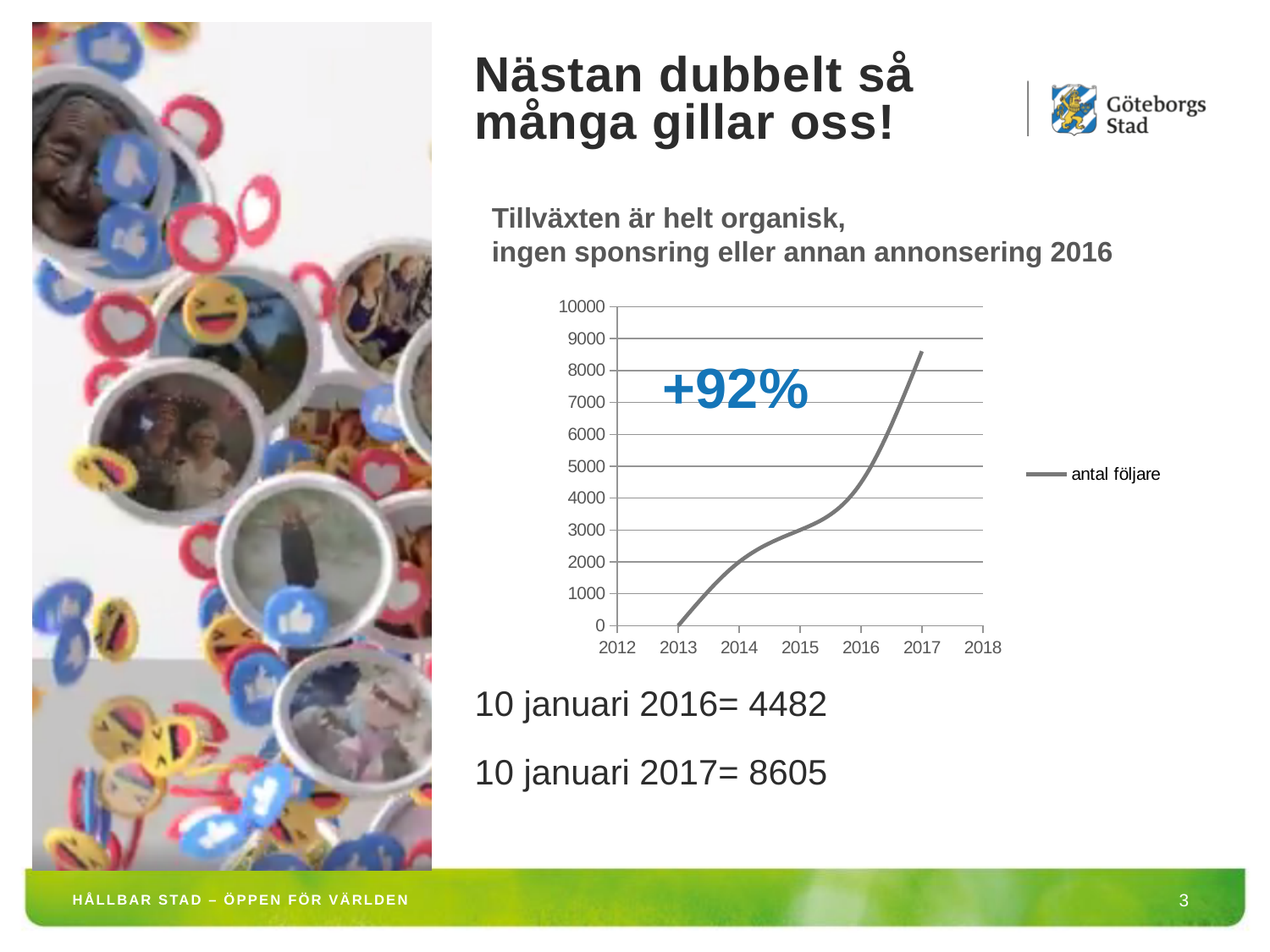
In which year does the line for antal följare reach its highest value? 2017 What kind of chart is shown on the slide? line chart Which year has the larger value for antal följare, 2015 or 2016? 2016 Is the value for antal följare in 2017 greater or less than 8000? greater Is the value for antal följare in 2015 greater or less than 4000? less Do the values of antal följare rise or fall from 2013 to 2017? rise How many series does the chart legend list? 1 In which year does the line for antal följare have its lowest value? 2013 Is the value for antal följare in 2016 greater or less than 5000? less What is the name of the series shown in the chart legend? antal följare What percentage growth is annotated in large blue text on the chart? +92%